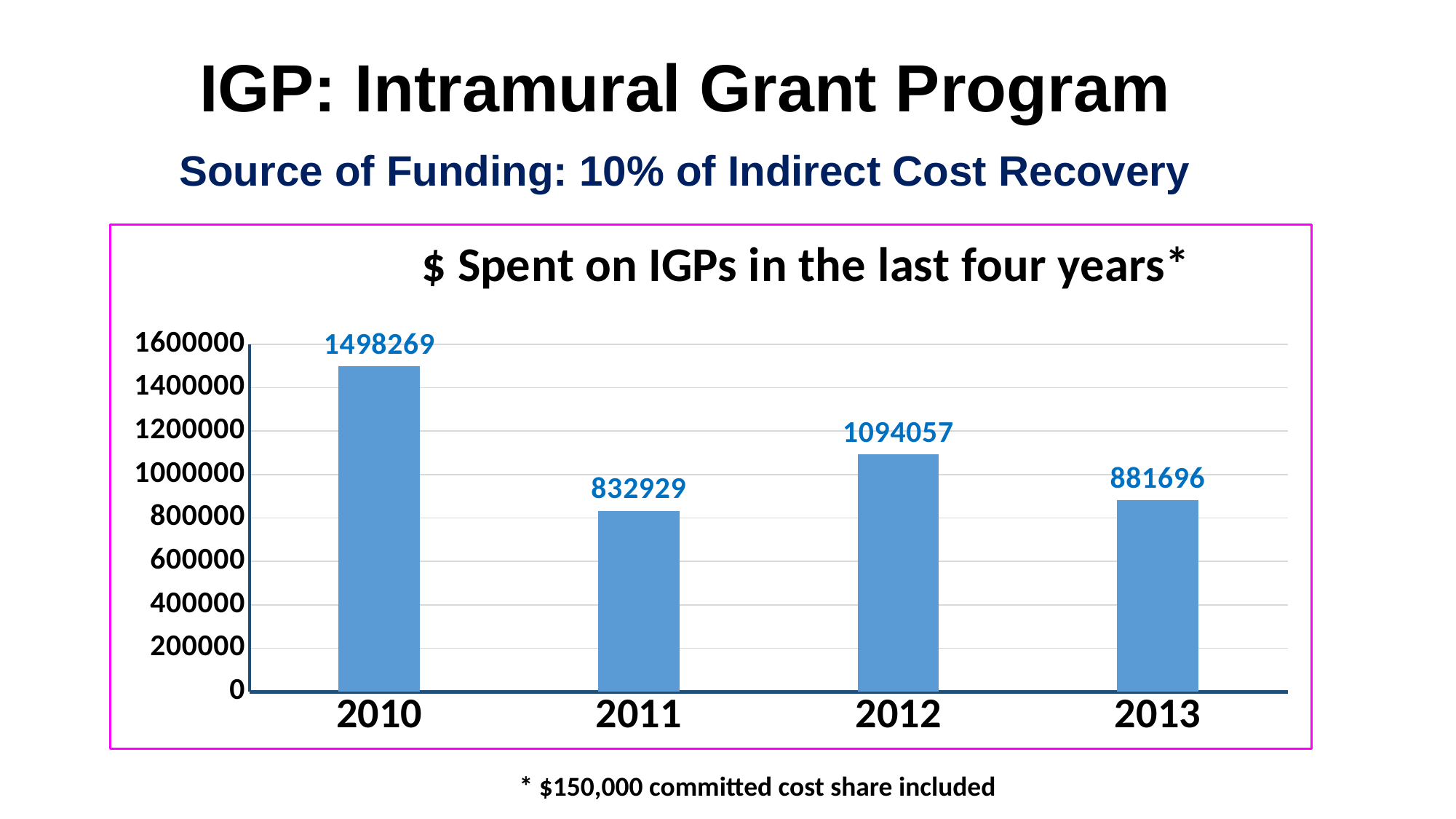
Which year has the highest value? 2010 What value is shown for 2012? 1094057 Is the value for 2012 greater or less than 1000000? greater What kind of chart is shown? bar chart What value is shown for 2010? 1498269 Which is larger, the value for 2012 or the value for 2013? 2012 How many years are shown on the x axis? 4 Which year has the lowest value? 2011 What value is shown for 2011? 832929 What is the difference between the values for 2010 and 2011? 665340 What is the difference between the values for 2012 and 2013? 212361 What value is shown for 2013? 881696